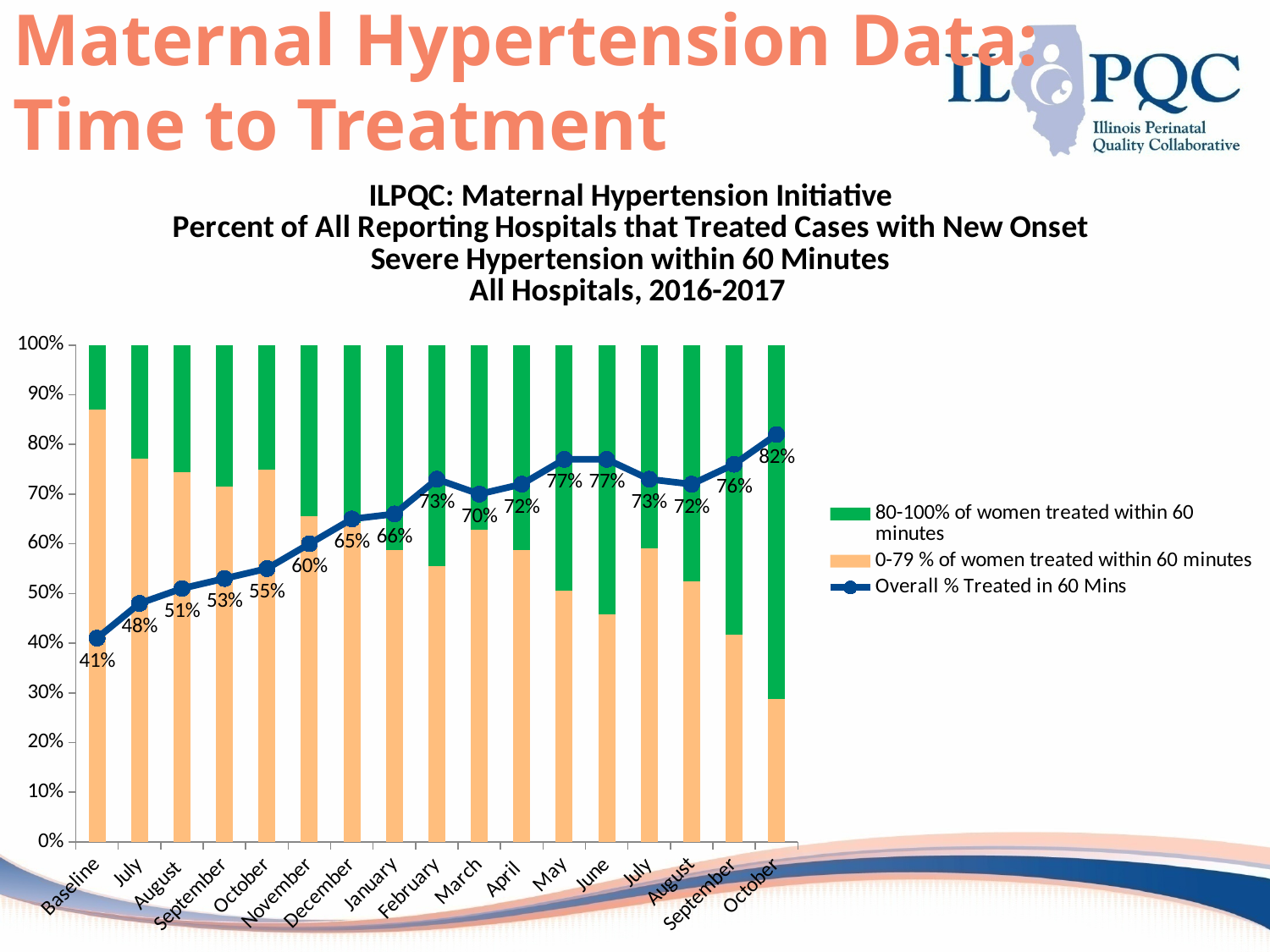
What kind of chart is this? Stacked bar chart with a line overlay How many categories are shown on the x axis? 17 What is the Overall % Treated in 60 Mins value at Baseline? 41% What is the Overall % Treated in 60 Mins value for the final October on the x axis? 82% How many series does the legend list? 3 What is the difference between the Overall % Treated in 60 Mins value for the last October and the Baseline value? 41% Does the Overall % Treated in 60 Mins line generally rise or fall from Baseline to the last October? Rise Which category has the lowest Overall % Treated in 60 Mins value? Baseline What is the Overall % Treated in 60 Mins value for December? 65% Which category has the highest Overall % Treated in 60 Mins value? October (the last category) Which is larger, the Overall % Treated in 60 Mins value for February or for March? February What is the Overall % Treated in 60 Mins value for March? 70%